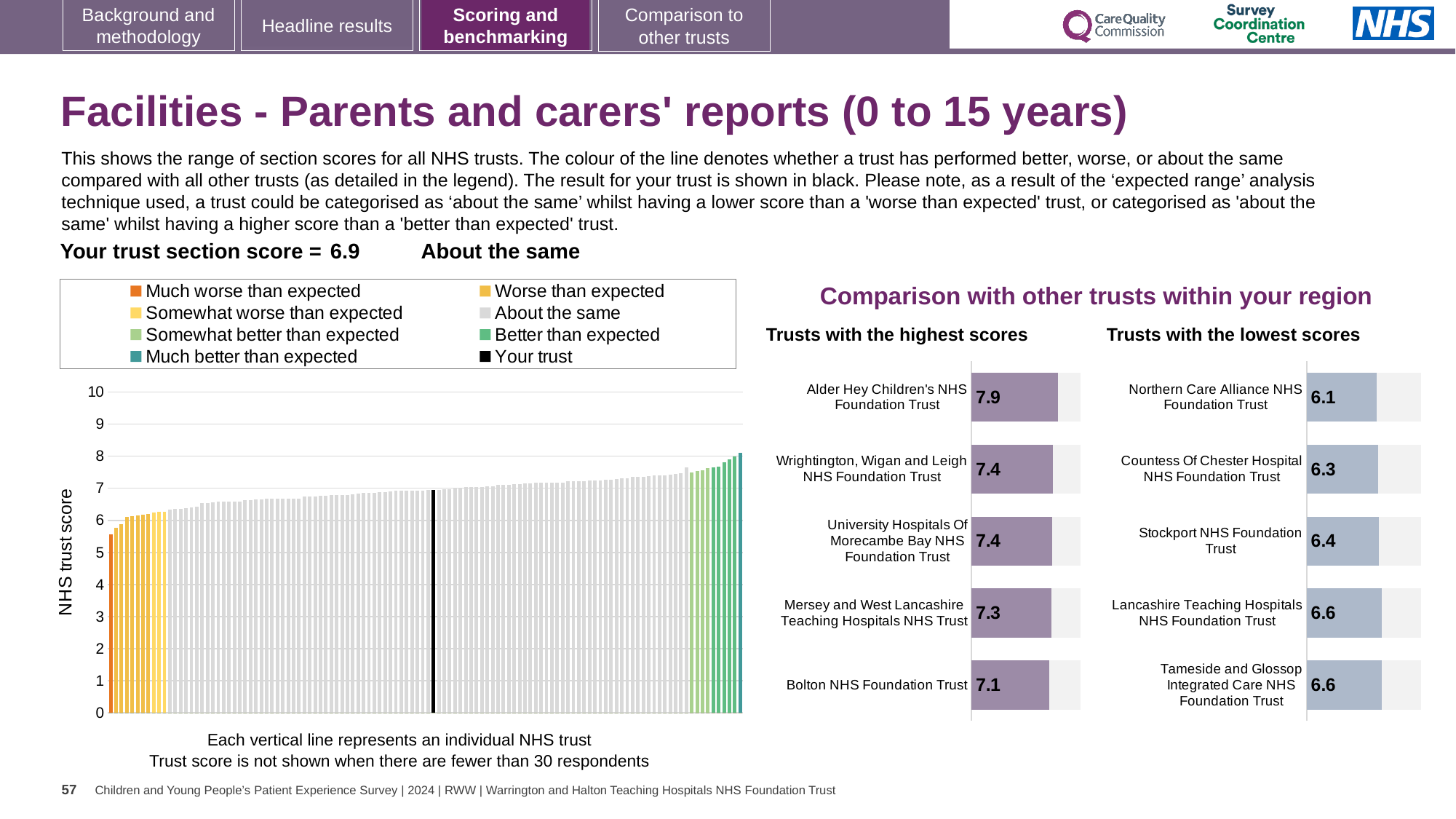
In the 'Trusts with the highest scores' chart, what is the difference between the scores of Alder Hey Children's NHS Foundation Trust and Bolton NHS Foundation Trust? 0.8 In the 'Trusts with the lowest scores' chart, what is the score for Stockport NHS Foundation Trust? 6.4 In the 'Trusts with the lowest scores' chart, which is larger: the score for Countess Of Chester Hospital NHS Foundation Trust or Stockport NHS Foundation Trust? Stockport NHS Foundation Trust In the NHS trust score chart on the left, do the bar values rise or fall from left to right? rise In the 'Trusts with the highest scores' chart, what is the score for Alder Hey Children's NHS Foundation Trust? 7.9 In the 'Trusts with the lowest scores' chart, what is the difference between the scores of Tameside and Glossop Integrated Care NHS Foundation Trust and Northern Care Alliance NHS Foundation Trust? 0.5 In the 'Trusts with the highest scores' chart, which trust has the lowest score? Bolton NHS Foundation Trust In the 'Trusts with the lowest scores' chart, which trust has the lowest score? Northern Care Alliance NHS Foundation Trust How many entries does the legend of the NHS trust score chart on the left list? 8 In the NHS trust score chart on the left, is the value of the leftmost (orange) bar greater or less than 6? less In the 'Trusts with the highest scores' chart, how many trusts are shown? 5 In the NHS trust score chart on the left, what is the section score for your trust (the black bar)? 6.9